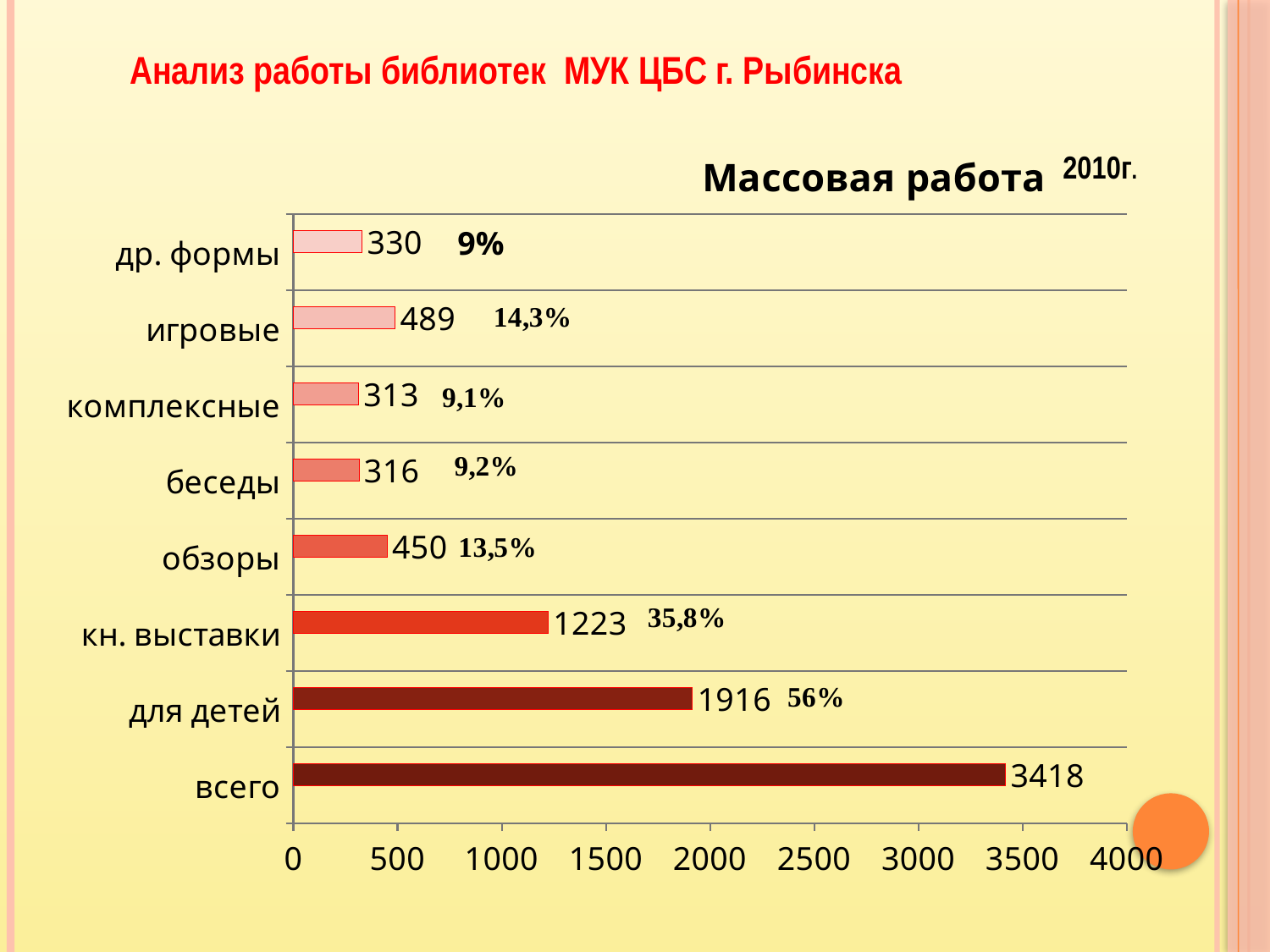
What percentage is printed next to the bar for "кн. выставки"? 35,8% Is the value for "для детей" greater or less than 1500? greater Which is larger, the value for "обзоры" or the value for "игровые"? игровые What is the value for "игровые"? 489 Which category has the lowest value? комплексные What kind of chart is shown on the slide? bar chart What is the difference between the values for "для детей" and "кн. выставки"? 693 How many categories are shown on the chart? 8 Which category has the highest value? всего What is the title of the chart? Массовая работа What is the value for "кн. выставки"? 1223 What is the value for "всего"? 3418